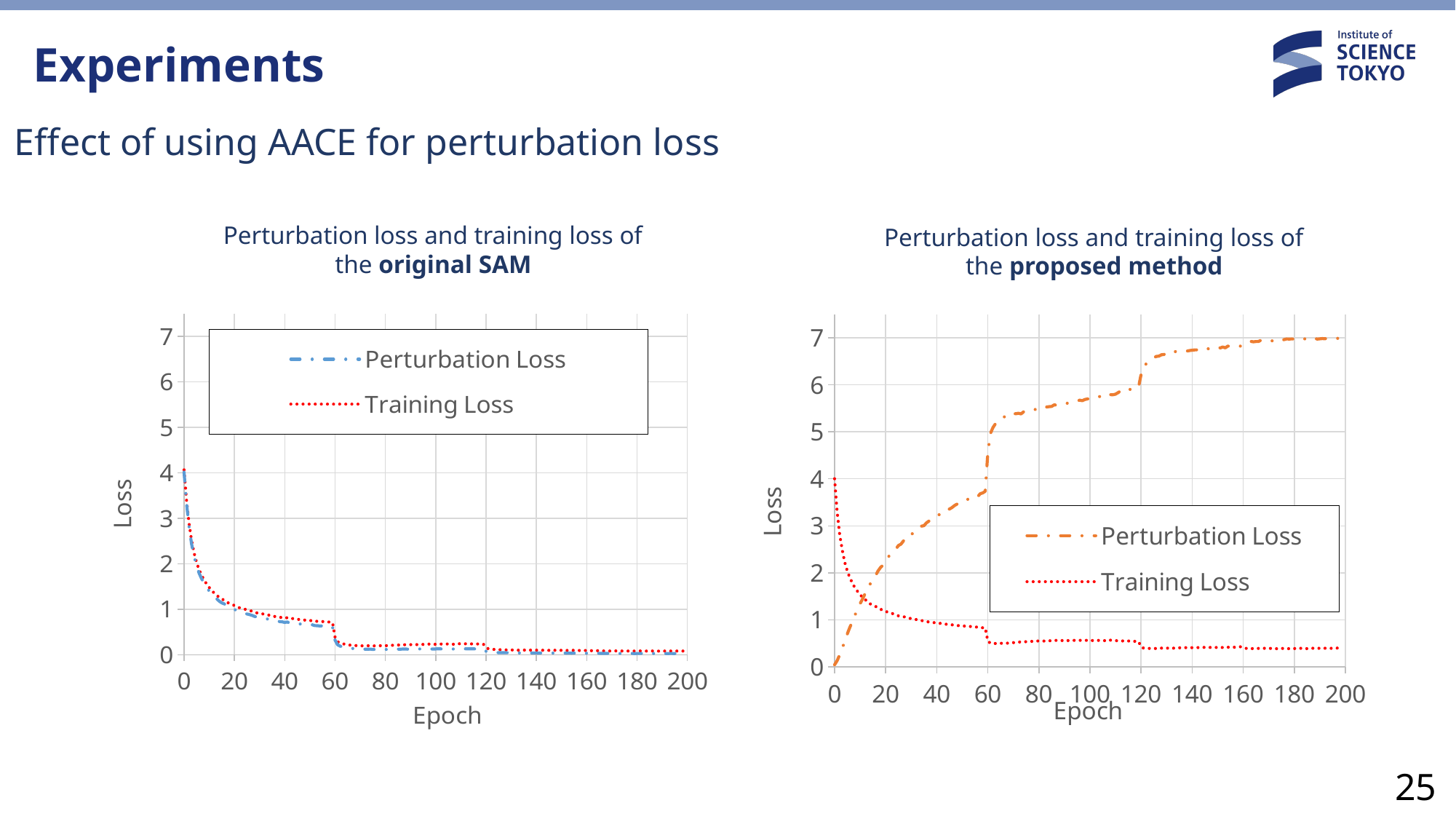
In the left chart (original SAM), is the Training Loss at epoch 0 greater or less than 3? greater What is the label of the y axis on the right chart (proposed method)? Loss In the right chart (proposed method), does the Training Loss rise or fall as the epoch increases? fall In the right chart (proposed method), is the Perturbation Loss at epoch 200 greater or less than 6? greater What is the label of the x axis on the left chart (original SAM)? Epoch In the right chart (proposed method), is the Training Loss at epoch 200 greater or less than 1? less How many series does the legend of the right chart, 'Perturbation loss and training loss of the proposed method', list? 2 In the left chart (original SAM), does the Perturbation Loss rise or fall as the epoch increases? fall In the right chart (proposed method), does the Perturbation Loss rise or fall as the epoch increases? rise What kind of chart is the left chart, titled 'Perturbation loss and training loss of the original SAM'? line chart In the right chart (proposed method), which series has the higher value at epoch 200, Perturbation Loss or Training Loss? Perturbation Loss